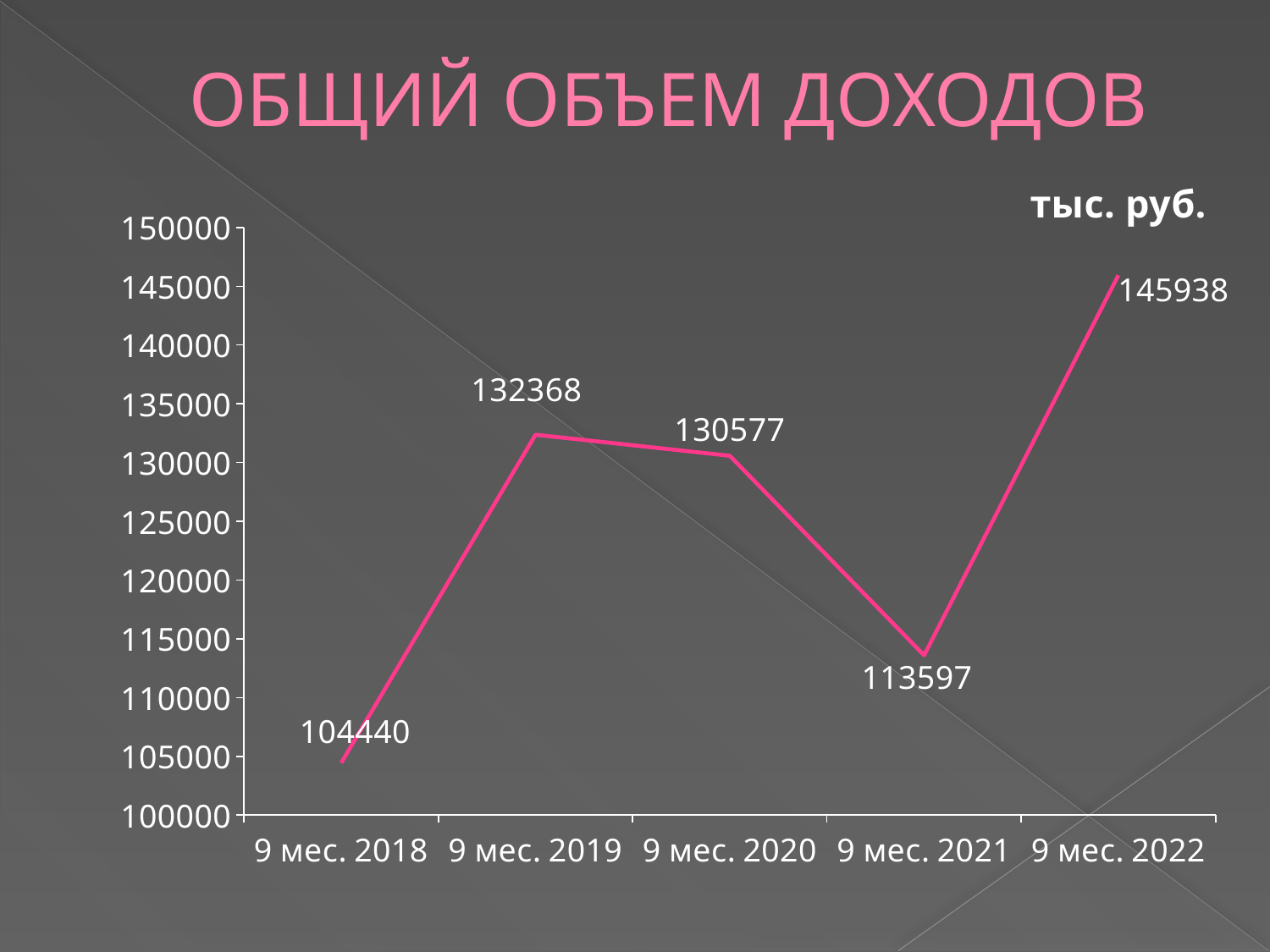
Which period has the highest value? 9 мес. 2022 Which period has the lowest value? 9 мес. 2018 What is the difference between the values for 9 мес. 2019 and 9 мес. 2020? 1791 What is the value for 9 мес. 2018? 104440 What is the difference between the values for 9 мес. 2022 and 9 мес. 2021? 32341 What is the value for 9 мес. 2021? 113597 Is the value for 9 мес. 2021 greater or less than 115000? less What is the title of the chart? тыс. руб. Which is larger, the value for 9 мес. 2019 or 9 мес. 2020? 9 мес. 2019 What kind of chart is shown on the slide? line chart What is the value for 9 мес. 2022? 145938 How many periods are plotted on the chart? 5